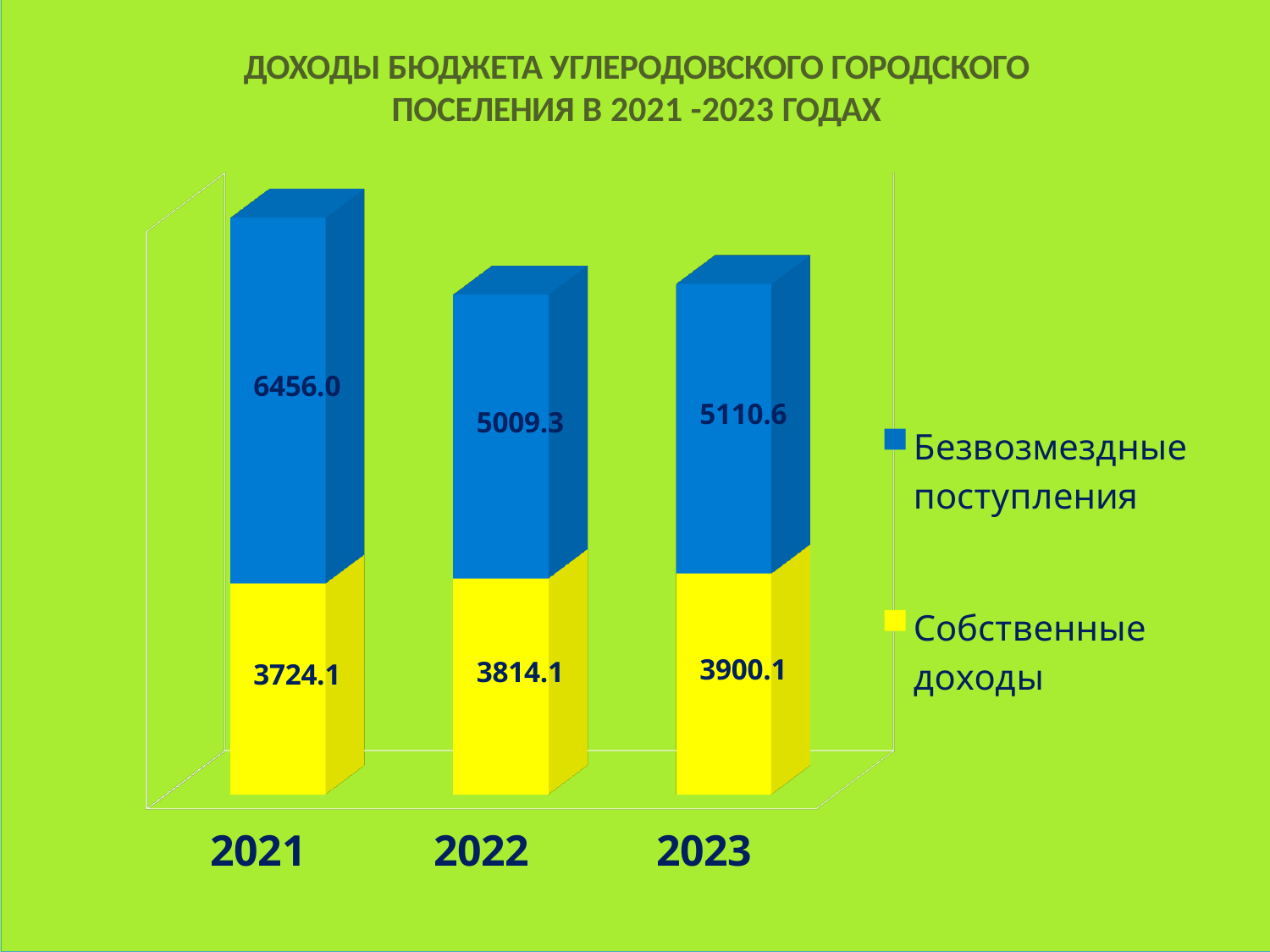
Which is larger: Безвозмездные поступления in 2022 or in 2023? 2023 How many series does the legend list? 2 In which year is Безвозмездные поступления highest? 2021 What is the difference between Собственные доходы in 2023 and 2021? 176.0 What is the value of Безвозмездные поступления for 2021? 6456.0 What is the difference between Безвозмездные поступления in 2021 and 2022? 1446.7 What is the total of the stacked bar for 2022? 8823.4 In which year is Собственные доходы lowest? 2021 What is the total of the stacked bar for 2021? 10180.1 What is the value of Собственные доходы for 2023? 3900.1 How many years are shown on the x axis? 3 What is the value of Безвозмездные поступления for 2022? 5009.3